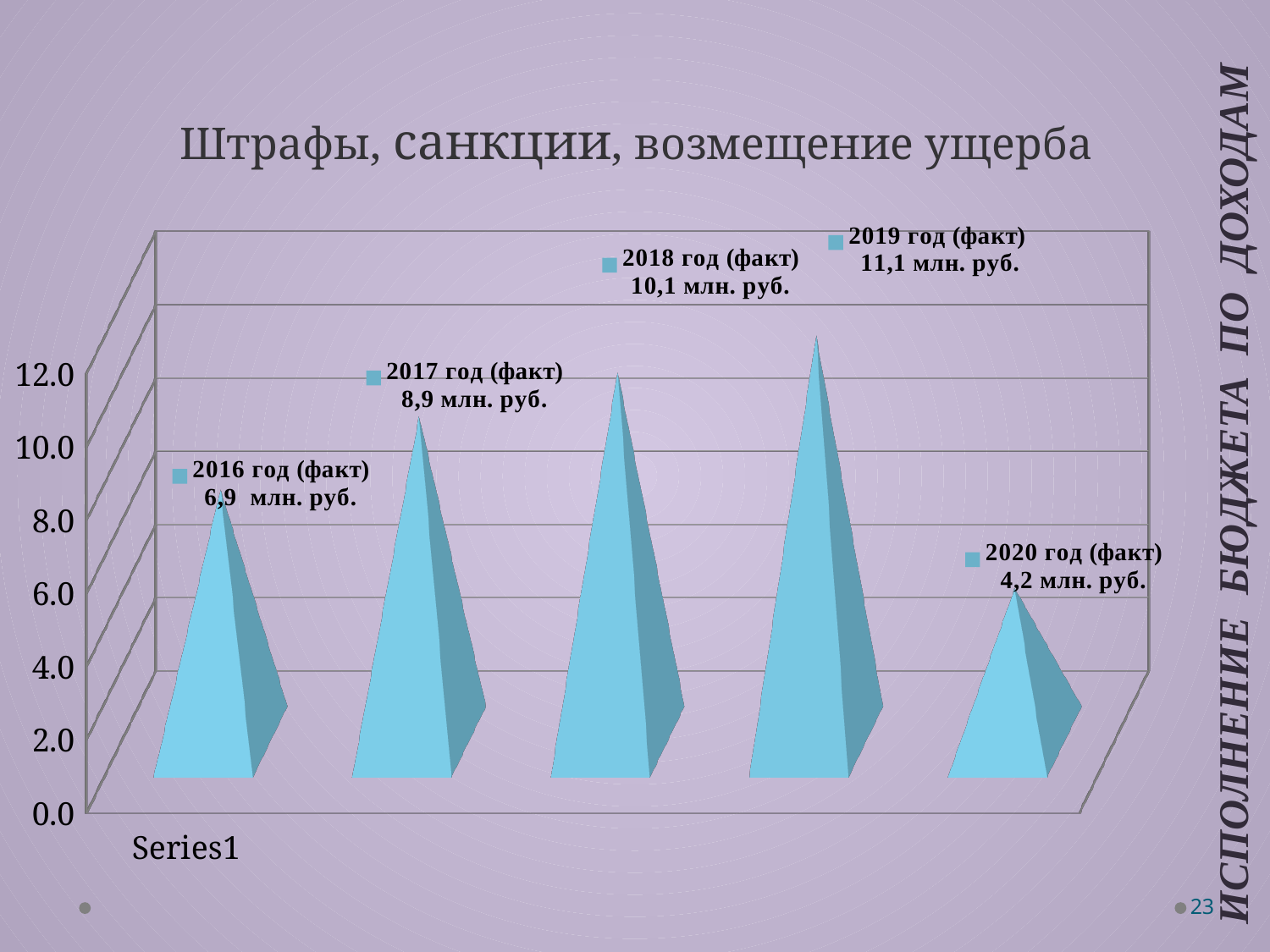
What is the difference between the values for 2017 год (факт) and 2016 год (факт)? 2,0 млн. руб. Which year has the lowest value? 2020 год (факт) Which year has the highest value? 2019 год (факт) Is the value for 2020 год (факт) greater or less than 6.0? less How many years are shown in the chart? 5 What is the value for 2020 год (факт)? 4,2 млн. руб. What is the difference between the values for 2019 год (факт) and 2018 год (факт)? 1,0 млн. руб. What is the title of the chart? Штрафы, санкции, возмещение ущерба What is the value for 2019 год (факт)? 11,1 млн. руб. What is the value for 2016 год (факт)? 6,9 млн. руб. What kind of chart is shown on the slide? bar chart Which is larger, the value for 2018 год (факт) or 2017 год (факт)? 2018 год (факт)